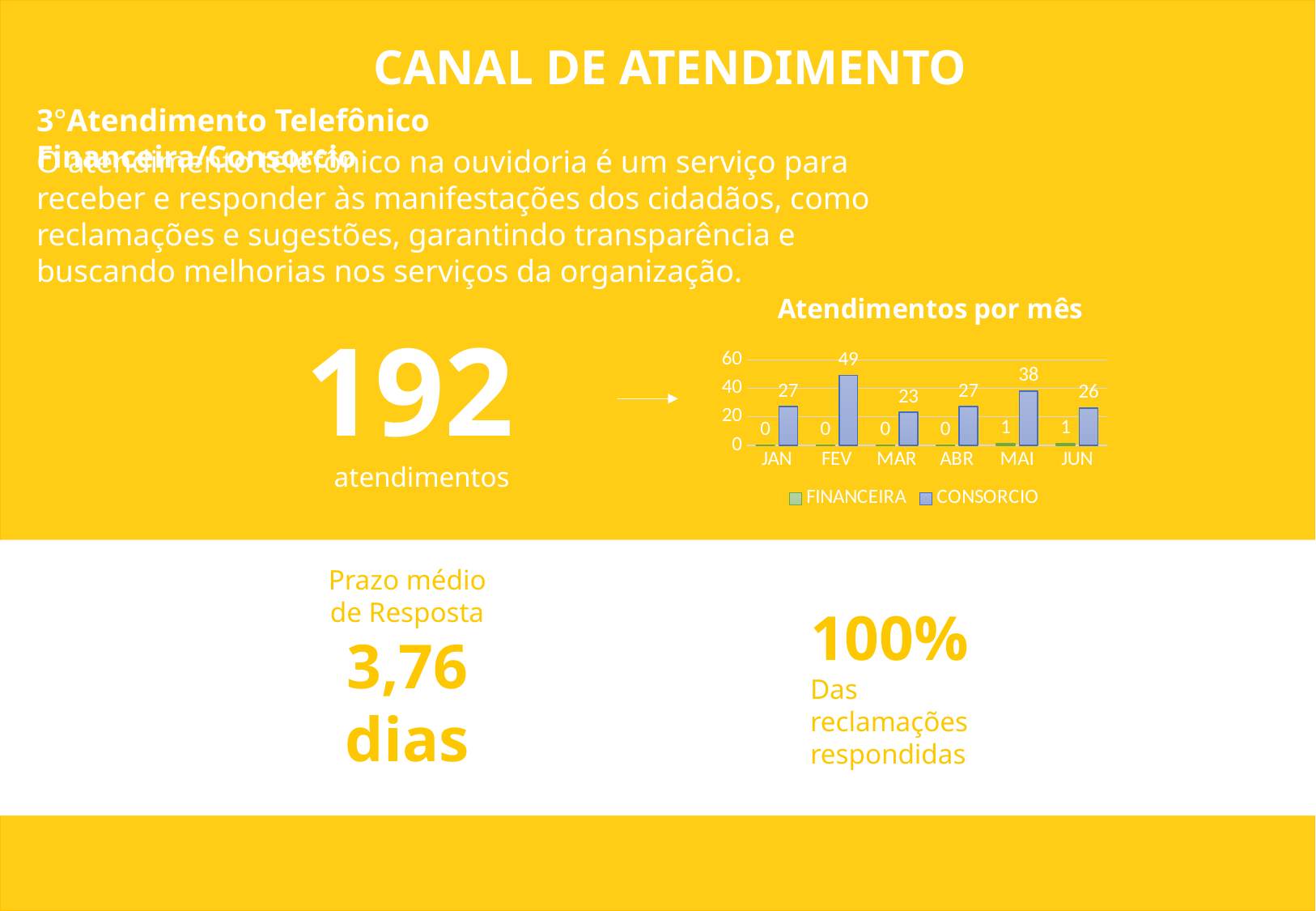
What is the CONSORCIO value for MAI in the 'Atendimentos por mês' chart? 38 How many months are shown on the x axis of the 'Atendimentos por mês' chart? 6 What is the difference between the CONSORCIO values for FEV and MAR in the 'Atendimentos por mês' chart? 26 What is the FINANCEIRA value for MAR in the 'Atendimentos por mês' chart? 0 Which month has the lowest CONSORCIO value in the 'Atendimentos por mês' chart? MAR What are the two series named in the legend of the 'Atendimentos por mês' chart? FINANCEIRA and CONSORCIO How many series does the legend of the 'Atendimentos por mês' chart list? 2 What is the CONSORCIO value for FEV in the 'Atendimentos por mês' chart? 49 What kind of chart is 'Atendimentos por mês'? Bar chart In the 'Atendimentos por mês' chart, is the CONSORCIO value for MAI larger than the CONSORCIO value for JUN? Yes Which month has the highest CONSORCIO value in the 'Atendimentos por mês' chart? FEV What is the FINANCEIRA value for JUN in the 'Atendimentos por mês' chart? 1